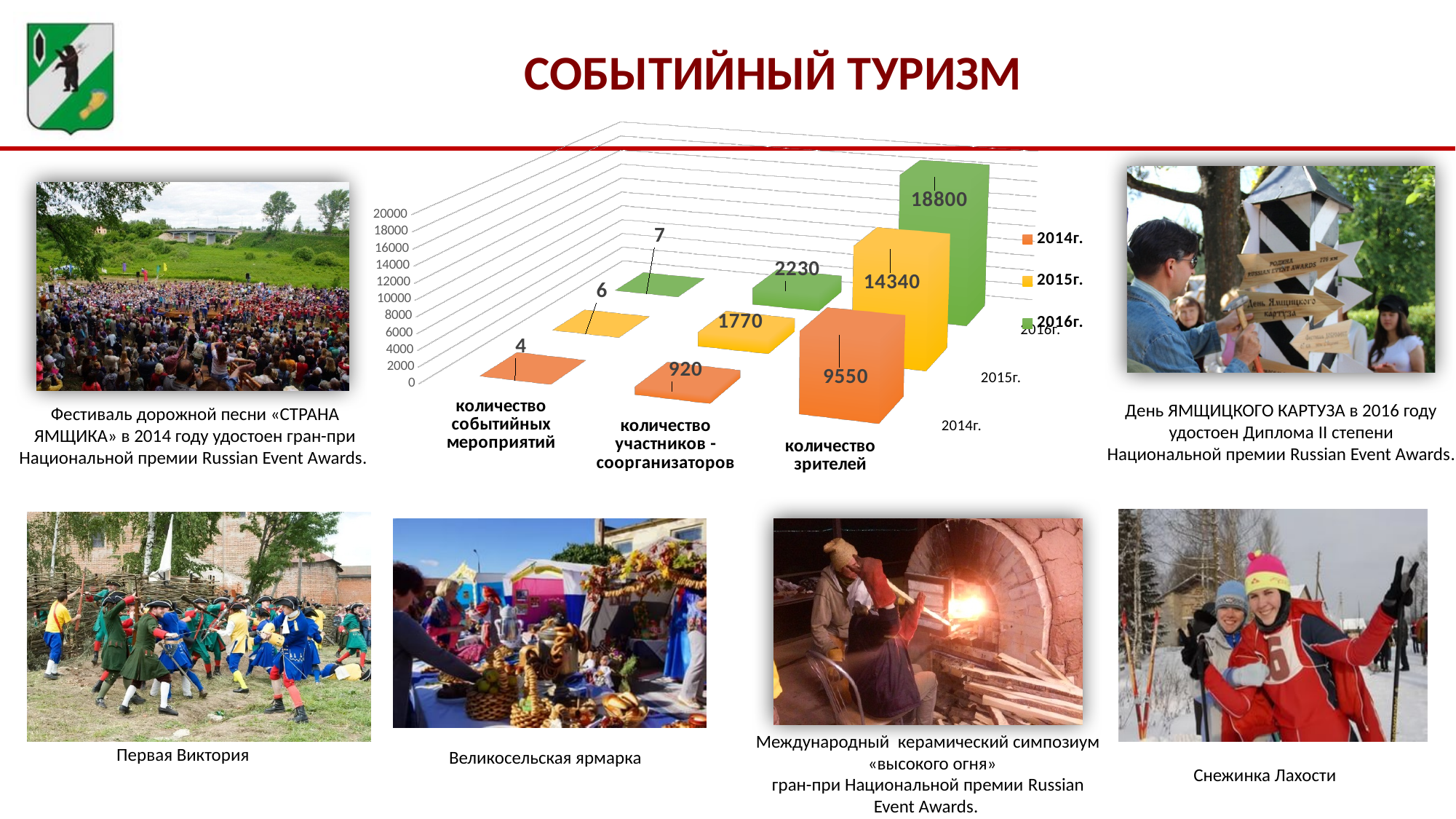
What is the value for количество зрителей in 2014г.? 9550 What is the value for количество событийных мероприятий in 2014г.? 4 Which year has the lowest value for количество участников - соорганизаторов? 2014г. Which year has the highest value for количество зрителей? 2016г. What is the value for количество зрителей in 2016г.? 18800 What is the value for количество участников - соорганизаторов in 2015г.? 1770 What kind of chart is shown on the slide? bar chart Do the values for количество зрителей rise or fall from 2014г. to 2016г.? rise Which is larger: количество участников - соорганизаторов in 2016г. or in 2015г.? 2016г. What is the difference between количество зрителей in 2016г. and in 2015г.? 4460 How many categories are shown along the x axis of the chart? 3 How many series does the chart legend list? 3